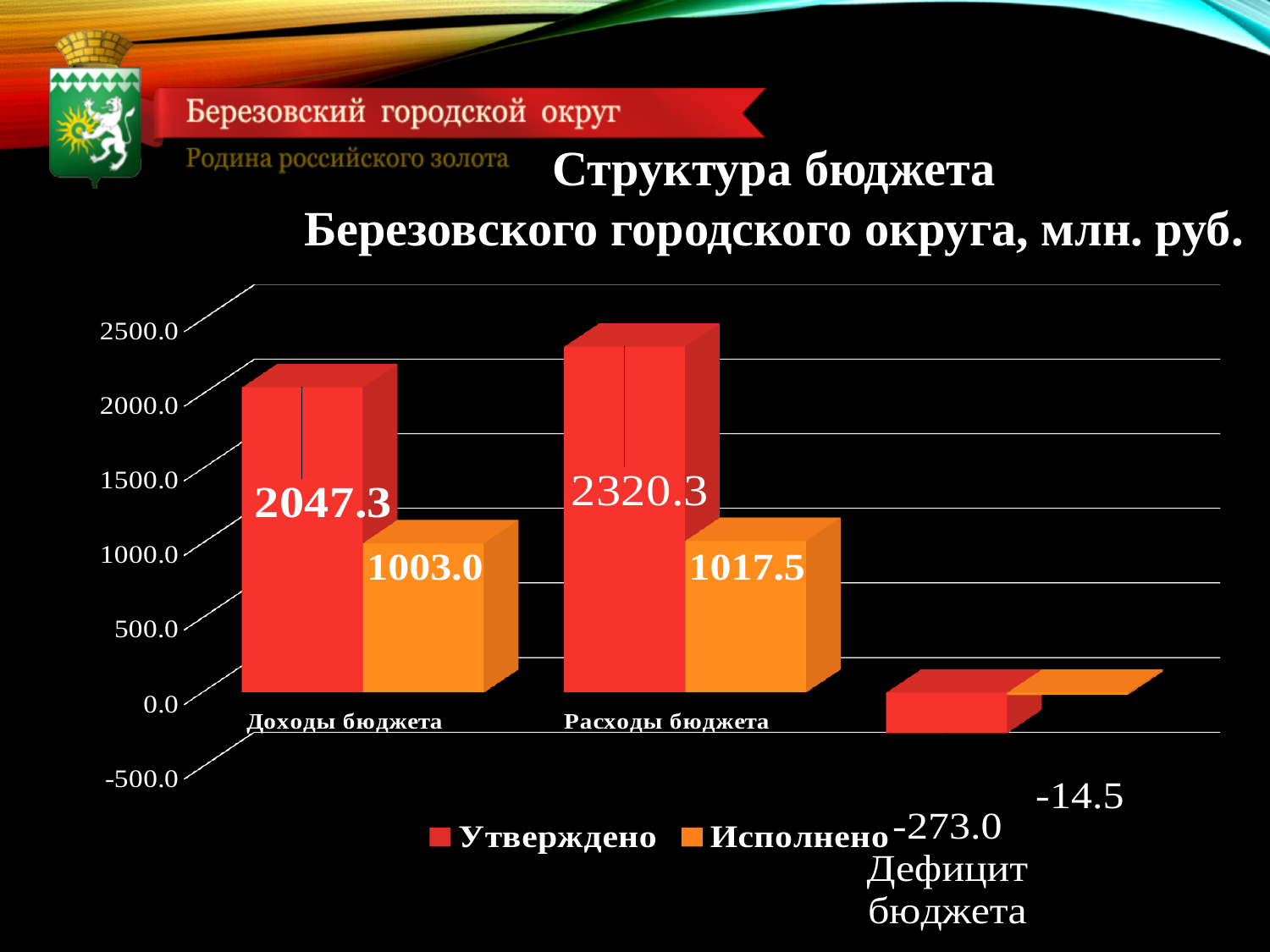
Which category has the lowest Исполнено value? Дефицит бюджета What is the value of Исполнено for Расходы бюджета? 1017.5 What is the value of Утверждено for Доходы бюджета? 2047.3 Which colour represents the Исполнено series? Orange What is the value of Утверждено for Дефицит бюджета? -273.0 Which category has the highest Утверждено value? Расходы бюджета How many categories are shown on the x axis? 3 Which is larger: the Исполнено value for Доходы бюджета or for Расходы бюджета? Расходы бюджета How many series does the legend list? 2 What is the difference between the Утверждено and Исполнено values for Доходы бюджета? 1044.3 What kind of chart is shown on the slide? Bar chart What is the value of Исполнено for Дефицит бюджета? -14.5